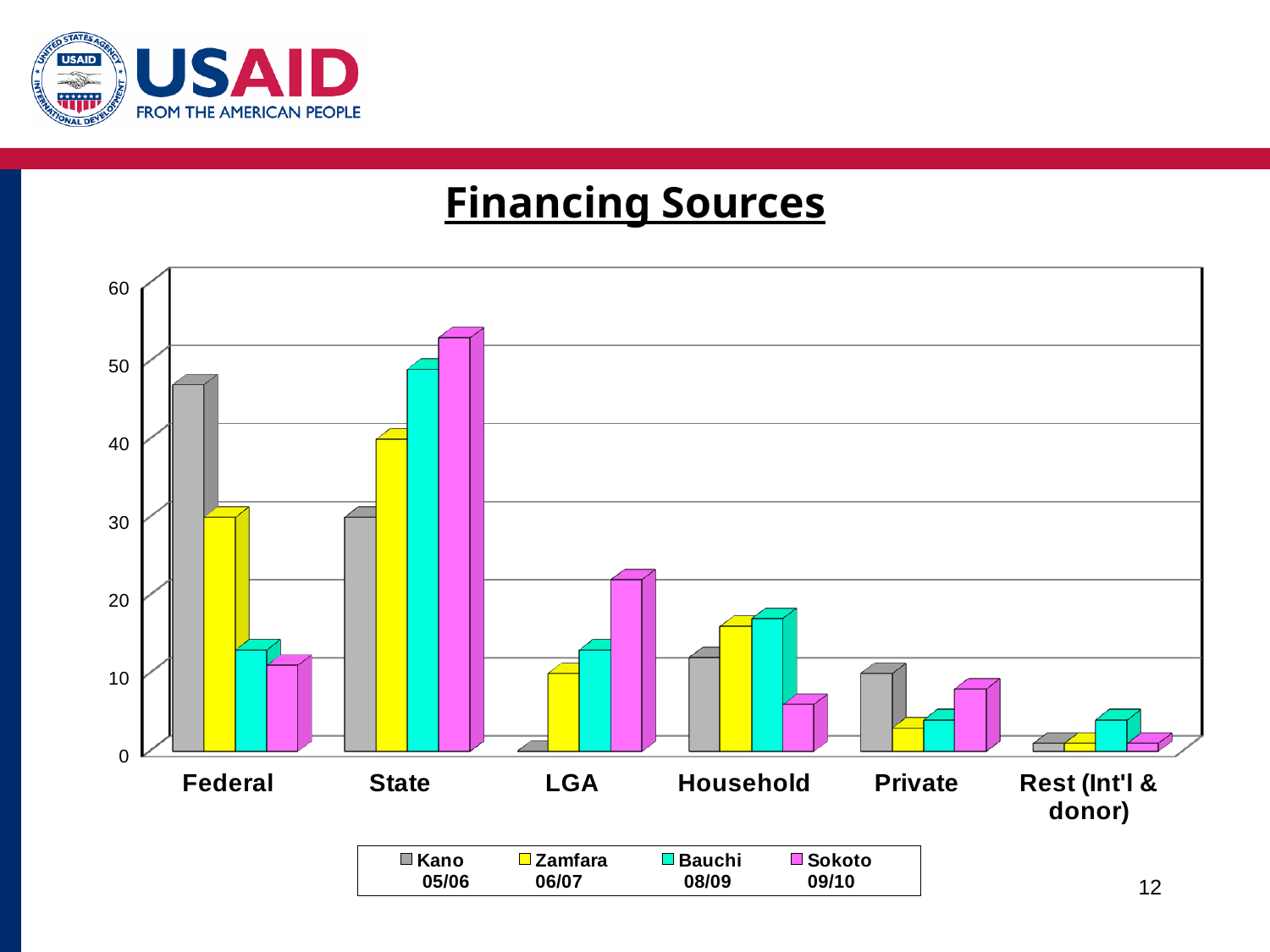
What kind of chart is shown on the slide? Bar chart Is the Kano 05/06 value for Federal greater or less than 40? greater Which series has the highest value in the State category? Sokoto 09/10 Which series has the lowest value in the LGA category? Kano 05/06 How many series does the legend list? 4 How many categories are shown on the x axis of the chart? 6 Which series is shown in yellow in the legend? Zamfara 06/07 For which category is the Kano 05/06 value highest? Federal For which category is the Sokoto 09/10 value highest? State Is the Sokoto 09/10 value for Household greater or less than 10? less What is the title of the chart? Financing Sources In the Federal category, which is larger: the Kano 05/06 value or the Zamfara 06/07 value? Kano 05/06